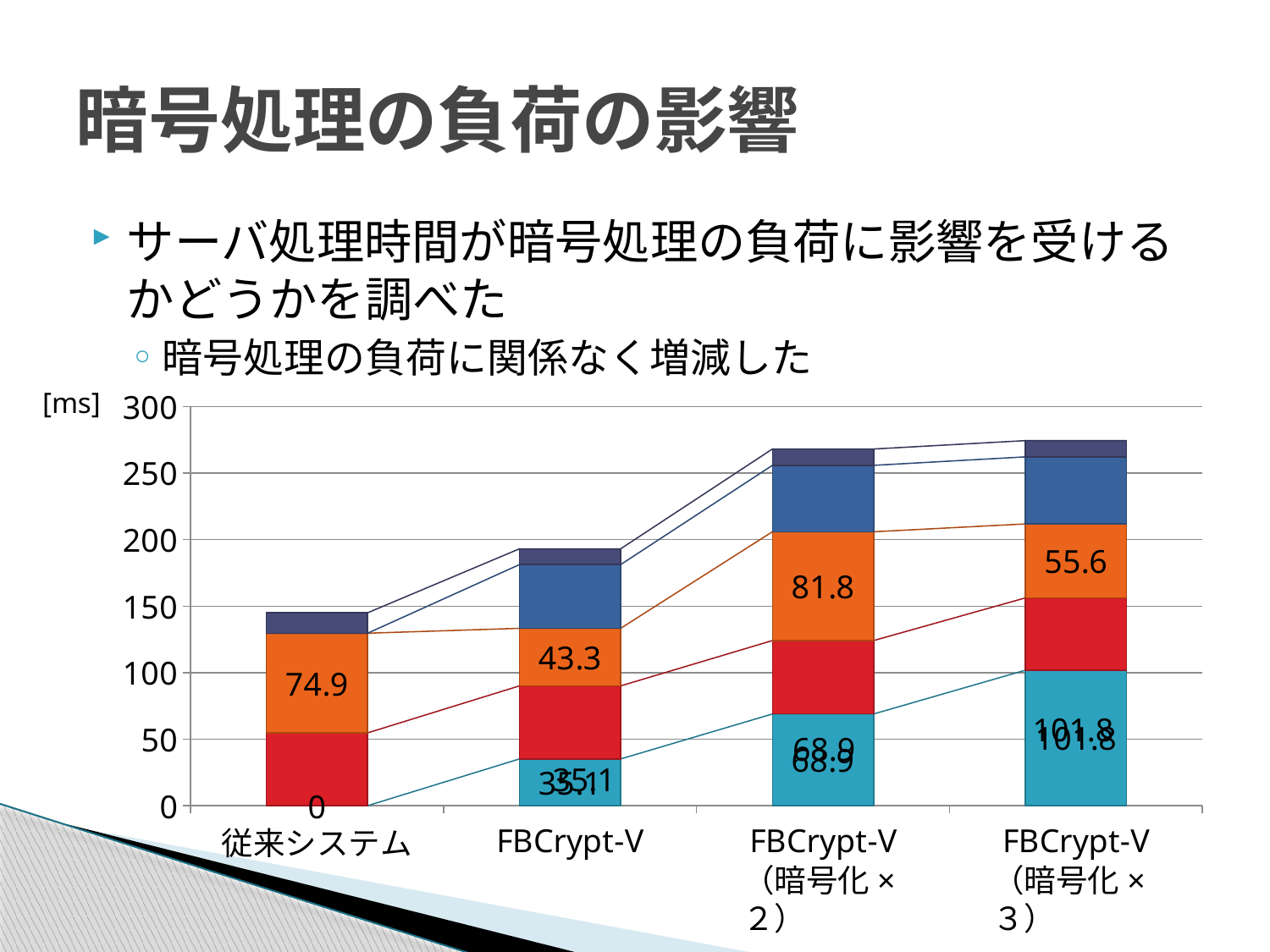
What is the value of the orange segment for FBCrypt-V（暗号化×2）? 81.8 What is the value of the orange segment for FBCrypt-V? 43.3 What is the value of the light blue segment for FBCrypt-V（暗号化×3）? 101.8 What is the value of the orange segment for 従来システム? 74.9 Is the total height of the bar for FBCrypt-V（暗号化×3） greater or less than 250? greater What type of chart is shown on the slide? stacked bar chart Which category has the largest orange segment value? FBCrypt-V（暗号化×2） What is the value of the orange segment for FBCrypt-V（暗号化×3）? 55.6 Which category has the smallest orange segment value? FBCrypt-V What is the value of the light blue segment for 従来システム? 0 How many categories are shown on the x axis of the chart? 4 What is the difference between the orange segment values for FBCrypt-V（暗号化×2） and FBCrypt-V（暗号化×3）? 26.2